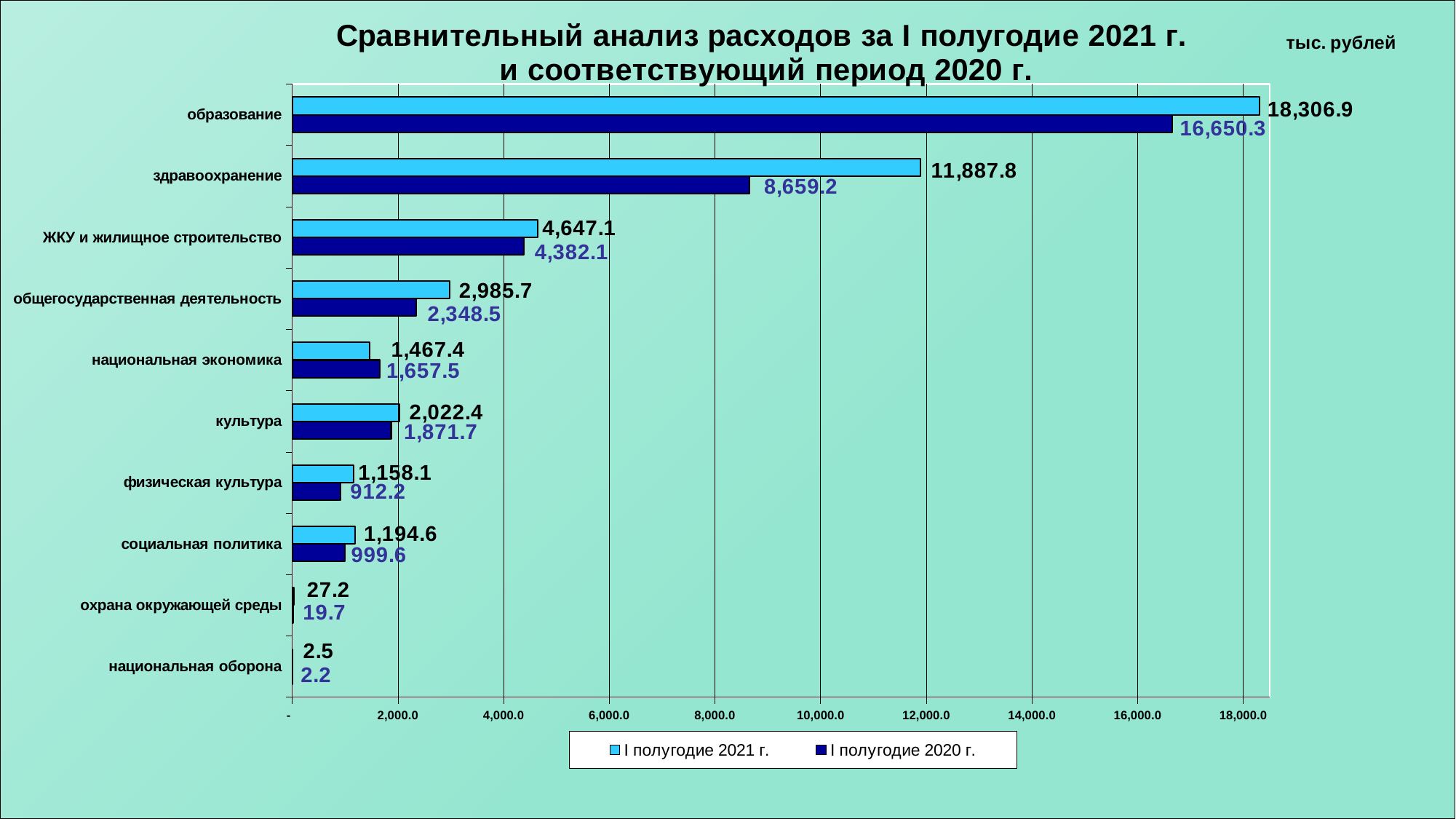
What type of chart is shown on the slide? bar chart Which category has the lowest value in I полугодие 2020 г.? национальная оборона Which category has the highest value in I полугодие 2021 г.? образование For национальная экономика, which is larger: the I полугодие 2021 г. value or the I полугодие 2020 г. value? I полугодие 2020 г. How many series does the legend list? 2 Is the value for ЖКУ и жилищное строительство in I полугодие 2021 г. greater or less than 4,000.0? greater How many categories are shown on the chart? 10 What is the value for физическая культура in I полугодие 2021 г.? 1,158.1 What is the value for здравоохранение in I полугодие 2020 г.? 8,659.2 What is the difference between the I полугодие 2021 г. and I полугодие 2020 г. values for здравоохранение? 3,228.6 What unit is indicated in the top right corner of the chart? тыс. рублей What is the value for образование in I полугодие 2021 г.? 18,306.9